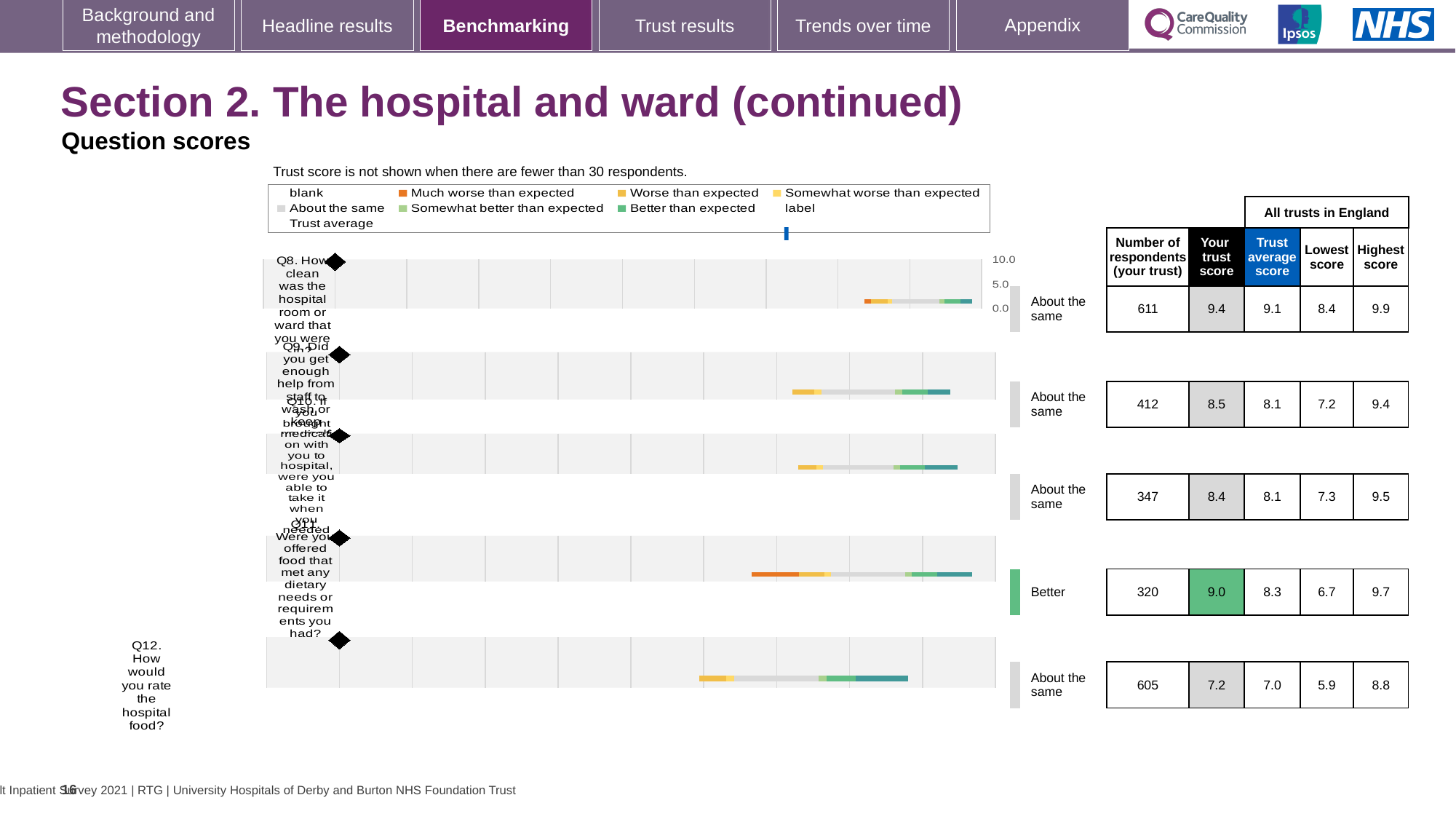
How many respondents from your trust answered Q12 (how would you rate the hospital food)? 605 What is the 'Highest score' across all trusts in England for Q10? 9.5 Which question has the highest 'Your trust score'? Q8 What kind of chart is used to show the question scores on this slide? bar chart What is the 'Your trust score' for Q8 (how clean was the hospital room or ward)? 9.4 Which question has the lowest 'Your trust score'? Q12 Which question is rated 'Better' rather than 'About the same'? Q11 How many questions (Q8 to Q12) are plotted in the chart? 5 For Q9, which is larger: the 'Your trust score' or the 'Trust average score'? Your trust score Which legend entry is shown in dark orange? Much worse than expected What is the 'Lowest score' across all trusts in England for Q11? 6.7 What is the difference between the 'Your trust score' and the 'Trust average score' for Q11? 0.7